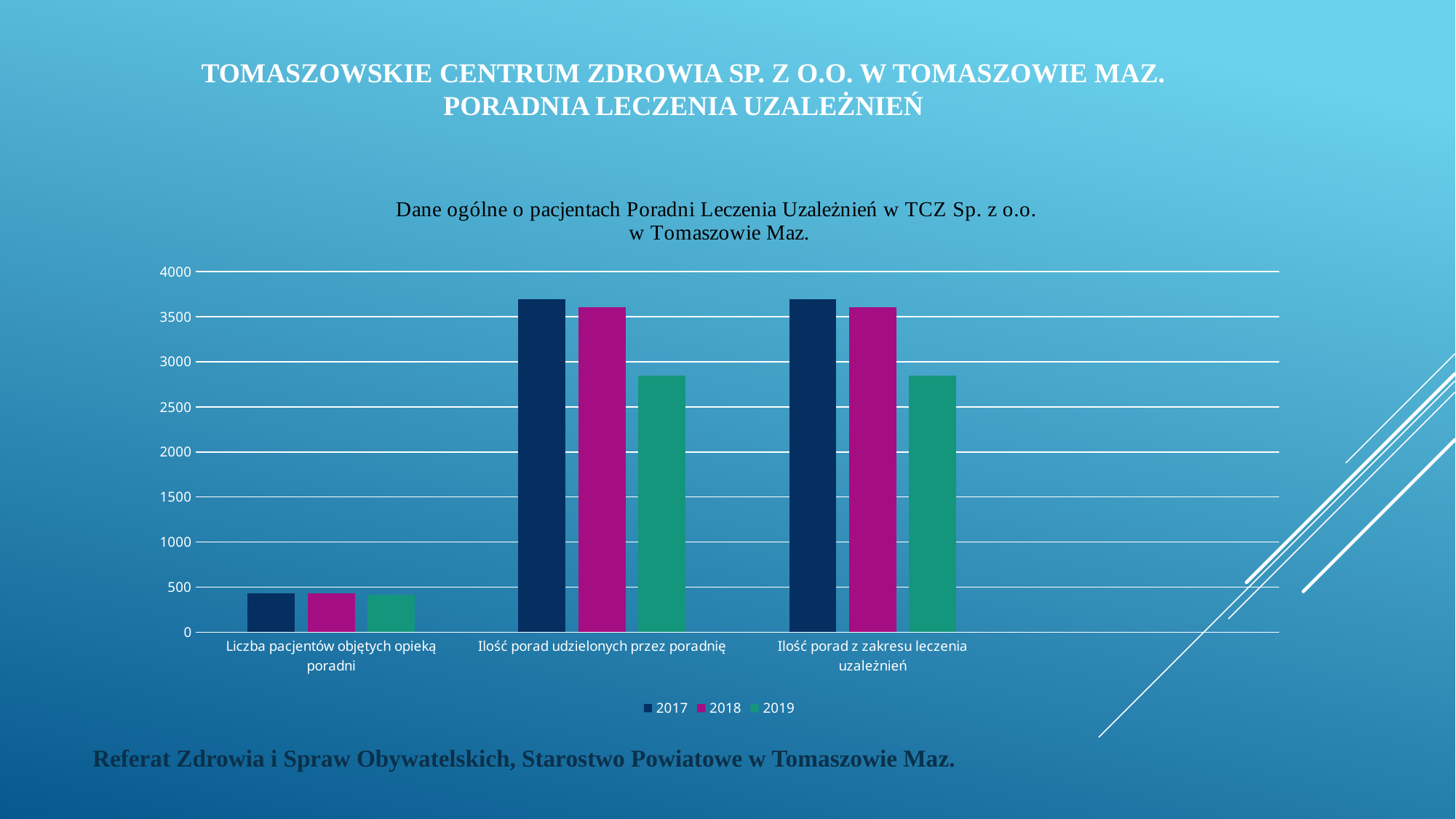
Is the 2017 value for Liczba pacjentów objętych opieką poradni greater or less than 500? less Is the 2017 value for Ilość porad udzielonych przez poradnię greater or less than 3500? greater What is the title of the chart? Dane ogólne o pacjentach Poradni Leczenia Uzależnień w TCZ Sp. z o.o. w Tomaszowie Maz. How many series does the legend list? 3 Which category has the lowest value for 2017? Liczba pacjentów objętych opieką poradni For Ilość porad z zakresu leczenia uzależnień, do the values rise or fall from 2017 to 2019? fall Is the 2019 value for Ilość porad udzielonych przez poradnię greater or less than 3000? less For Ilość porad udzielonych przez poradnię, which is larger: the 2017 value or the 2019 value? 2017 What kind of chart is shown on the slide? bar chart Which years are listed in the legend? 2017, 2018, 2019 How many categories are shown on the x axis? 3